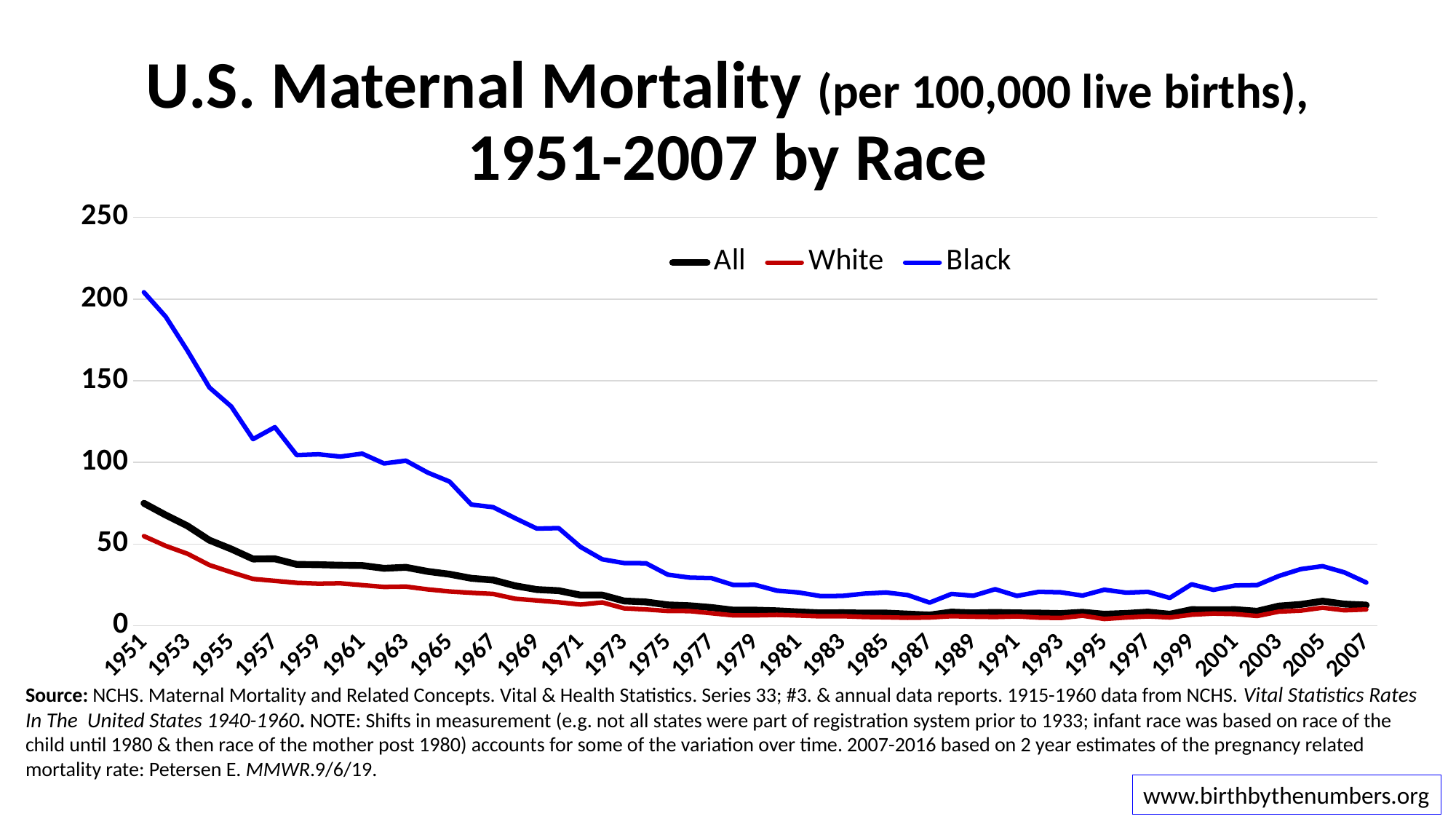
Which series has the lowest value in 1951? White What kind of chart is shown on the slide? line chart Does the Black series rise or fall from 1951 to 1987? fall What is the title of the chart? U.S. Maternal Mortality (per 100,000 live births), 1951-2007 by Race Is the value for Black in 1975 greater or less than 50? less How many series does the legend list? 3 Is the value for Black in 1965 greater or less than 100? less Is the value for All in 1951 greater or less than 50? greater Which is larger in 2007, the value for Black or the value for White? Black What colour is the line for the White series? red Which series has the highest value in 1951? Black